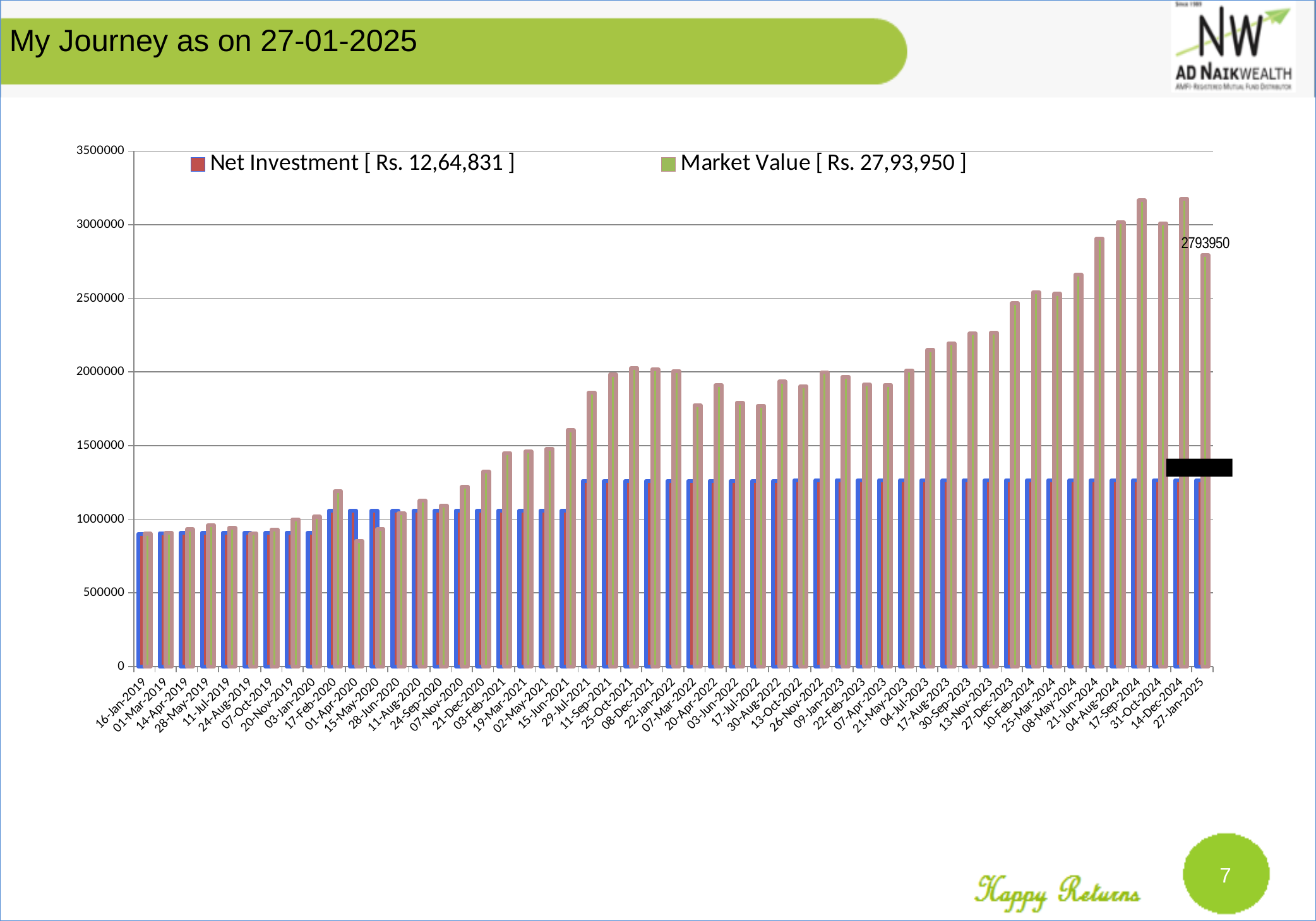
Does the Market Value generally rise or fall from 16-Jan-2019 to 14-Dec-2024? rise On 27-Jan-2025, which is larger, Net Investment or Market Value? Market Value Is the Net Investment on 27-Jan-2025 greater or less than 1500000? less On which date is the Market Value lowest? 01-Apr-2020 Is the Market Value on 29-Jul-2021 greater or less than 2000000? less What Net Investment amount is shown in the legend? Rs. 12,64,831 Which is larger, the Market Value on 14-Dec-2024 or on 27-Jan-2025? 14-Dec-2024 How many series does the legend list? 2 Is the Market Value on 16-Jan-2019 greater or less than 1000000? less What kind of chart is shown on the slide? bar chart What is the Market Value on 27-Jan-2025? 2793950